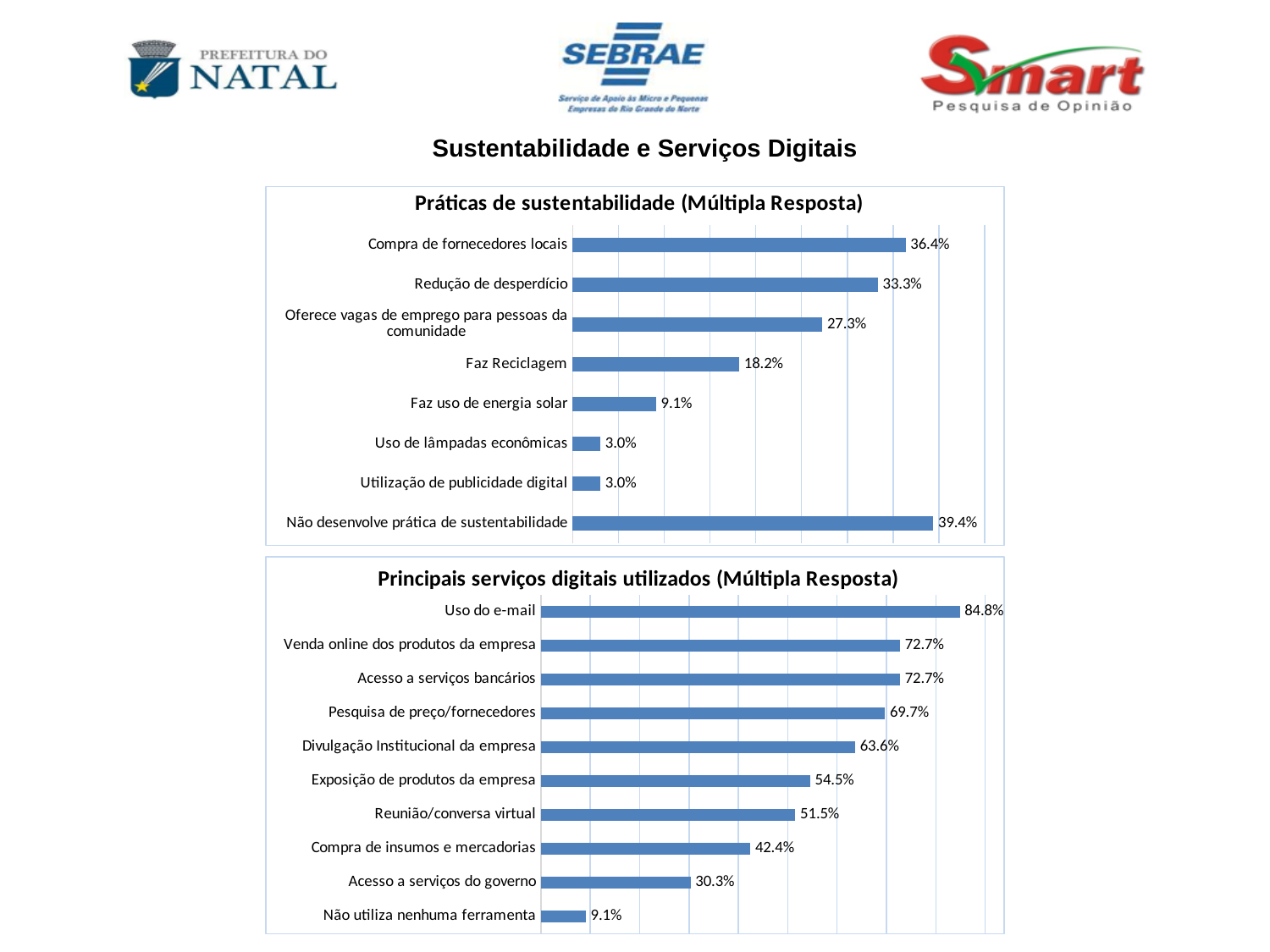
In the 'Práticas de sustentabilidade (Múltipla Resposta)' chart, what is the value for 'Faz uso de energia solar'? 9.1% In the 'Principais serviços digitais utilizados (Múltipla Resposta)' chart, which is larger: 'Reunião/conversa virtual' or 'Compra de insumos e mercadorias'? Reunião/conversa virtual In the 'Práticas de sustentabilidade (Múltipla Resposta)' chart, what is the difference between 'Redução de desperdício' and 'Faz Reciclagem'? 15.1% In the 'Principais serviços digitais utilizados (Múltipla Resposta)' chart, which category has the lowest value? Não utiliza nenhuma ferramenta In the 'Práticas de sustentabilidade (Múltipla Resposta)' chart, how many categories are shown? 8 In the 'Práticas de sustentabilidade (Múltipla Resposta)' chart, which category has the highest value? Não desenvolve prática de sustentabilidade In the 'Principais serviços digitais utilizados (Múltipla Resposta)' chart, what is the value for 'Divulgação Institucional da empresa'? 63.6% In the 'Principais serviços digitais utilizados (Múltipla Resposta)' chart, what is the value for 'Uso do e-mail'? 84.8% In the 'Principais serviços digitais utilizados (Múltipla Resposta)' chart, what is the difference between 'Uso do e-mail' and 'Acesso a serviços do governo'? 54.5% In the 'Principais serviços digitais utilizados (Múltipla Resposta)' chart, how many categories are shown? 10 What type of chart is the 'Principais serviços digitais utilizados (Múltipla Resposta)' chart? Bar chart In the 'Práticas de sustentabilidade (Múltipla Resposta)' chart, what is the value for 'Compra de fornecedores locais'? 36.4%